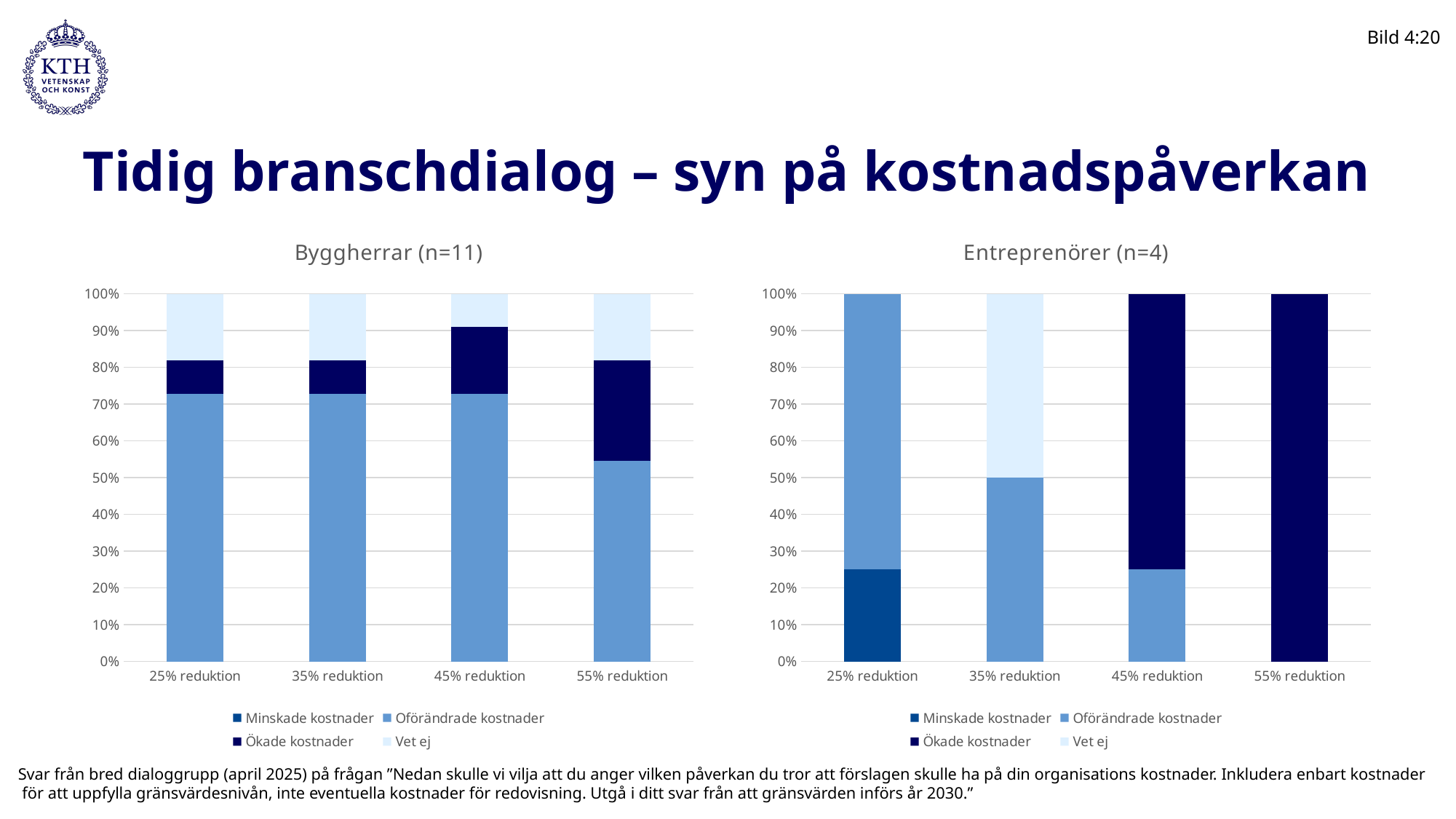
In the Byggherrar (n=11) chart, is the share of Oförändrade kostnader for 25% reduktion greater or less than 70%? greater What kind of chart is the Byggherrar (n=11) chart? Stacked bar chart What is the title of the chart on the right of the slide? Entreprenörer (n=4) In the Entreprenörer (n=4) chart, what is the share of Ökade kostnader for 55% reduktion? 100% How many categories are shown on the x axis of the Entreprenörer (n=4) chart? 4 In the Entreprenörer (n=4) chart, what is the share of Oförändrade kostnader for 35% reduktion? 50% In the Entreprenörer (n=4) chart, which category has the largest share of Ökade kostnader? 55% reduktion In the Entreprenörer (n=4) chart, what is the share of Vet ej for 35% reduktion? 50% How many series does the legend of the Byggherrar (n=11) chart list? 4 In the Byggherrar (n=11) chart, does the share of Ökade kostnader rise or fall from 25% reduktion to 55% reduktion? rise In the Entreprenörer (n=4) chart, is the share of Ökade kostnader larger for 45% reduktion or for 55% reduktion? 55% reduktion